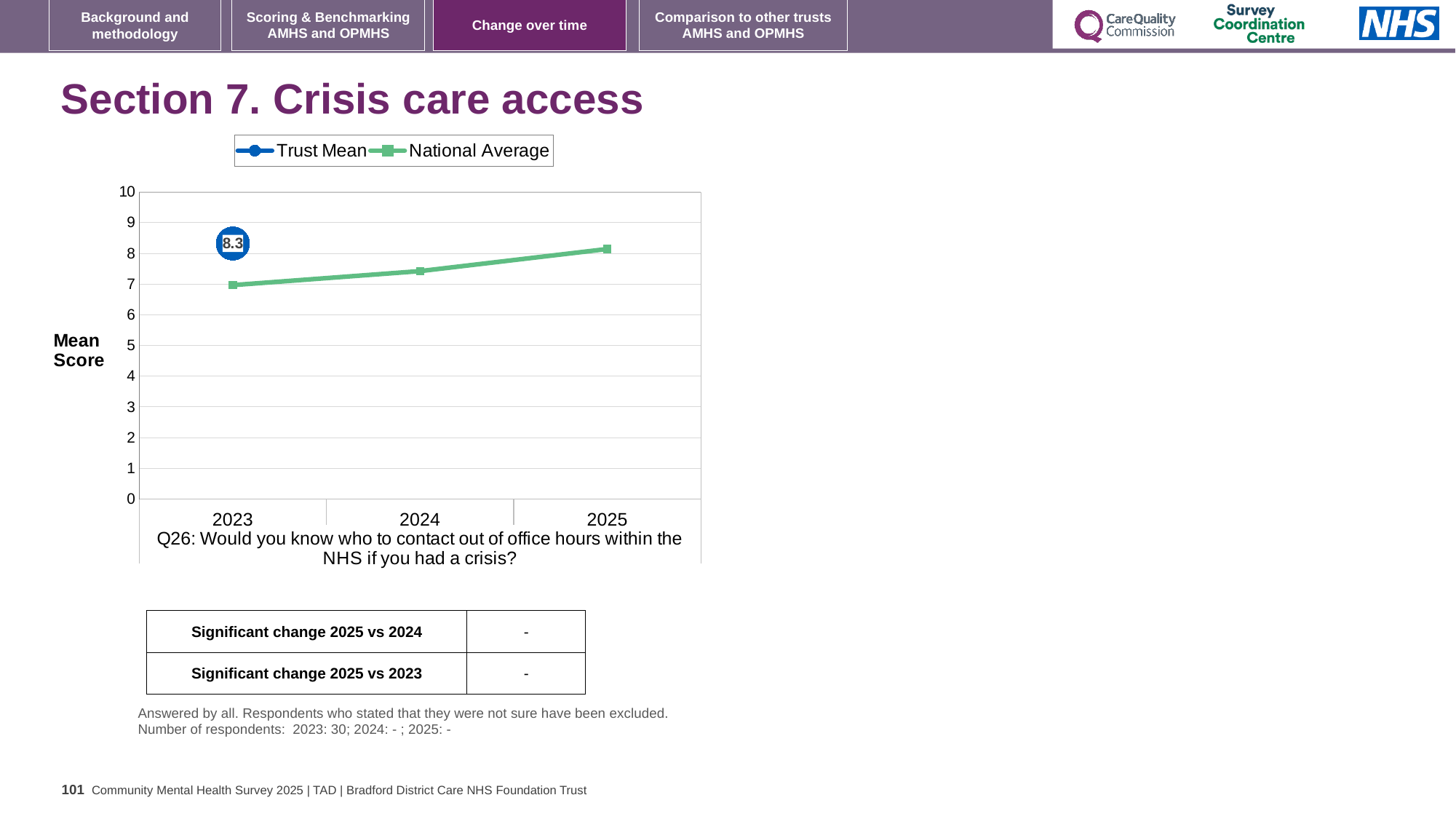
Is the National Average value for 2023 greater or less than 8? less Is the National Average value for 2025 greater or less than 7? greater Is the National Average value for 2024 greater or less than 8? less What kind of chart is shown on the slide? Line chart What is the label on the y axis of the chart? Mean Score What is the Trust Mean value for 2023? 8.3 In which year is the National Average lowest? 2023 In 2023, which is larger: the Trust Mean or the National Average? Trust Mean How many years are shown on the x axis? 3 How many series does the legend list? 2 Does the National Average rise or fall from 2023 to 2025? Rise In which year is the National Average highest? 2025